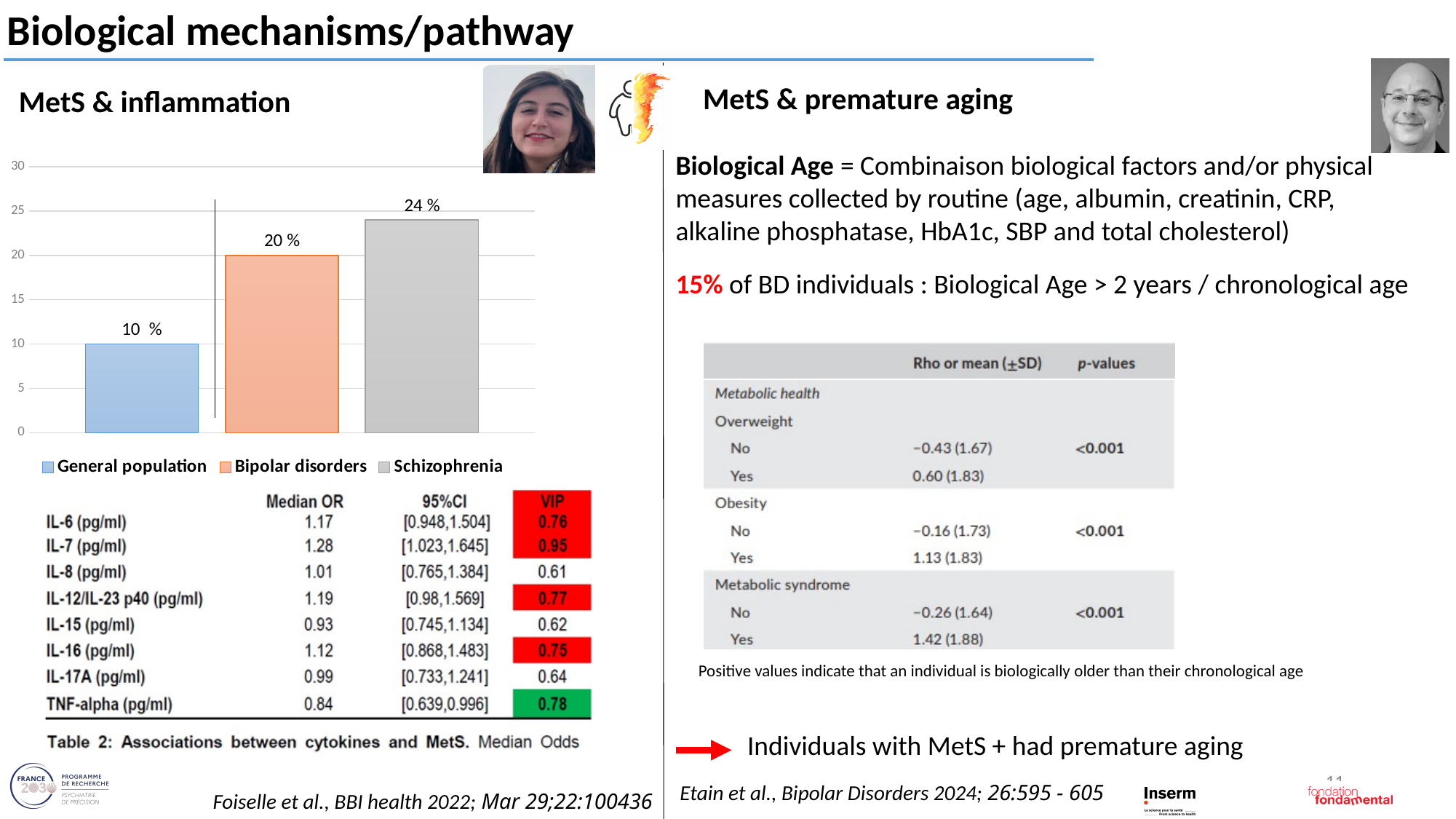
What is the difference between the Bipolar disorders and General population values in the bar chart? 10 % What value is shown for Schizophrenia in the bar chart? 24 % What value is shown for General population in the bar chart? 10 % What type of chart is shown under the heading 'MetS & inflammation'? Bar chart Which group has the highest value in the bar chart? Schizophrenia What value is shown for Bipolar disorders in the bar chart? 20 % How many entries does the legend of the bar chart list? 3 Is the value for Schizophrenia in the bar chart greater or less than 20? greater How many bars are plotted in the bar chart? 3 What is the difference between the Schizophrenia and General population values in the bar chart? 14 % Which group has the lowest value in the bar chart? General population Which is larger in the bar chart, the value for Bipolar disorders or for Schizophrenia? Schizophrenia